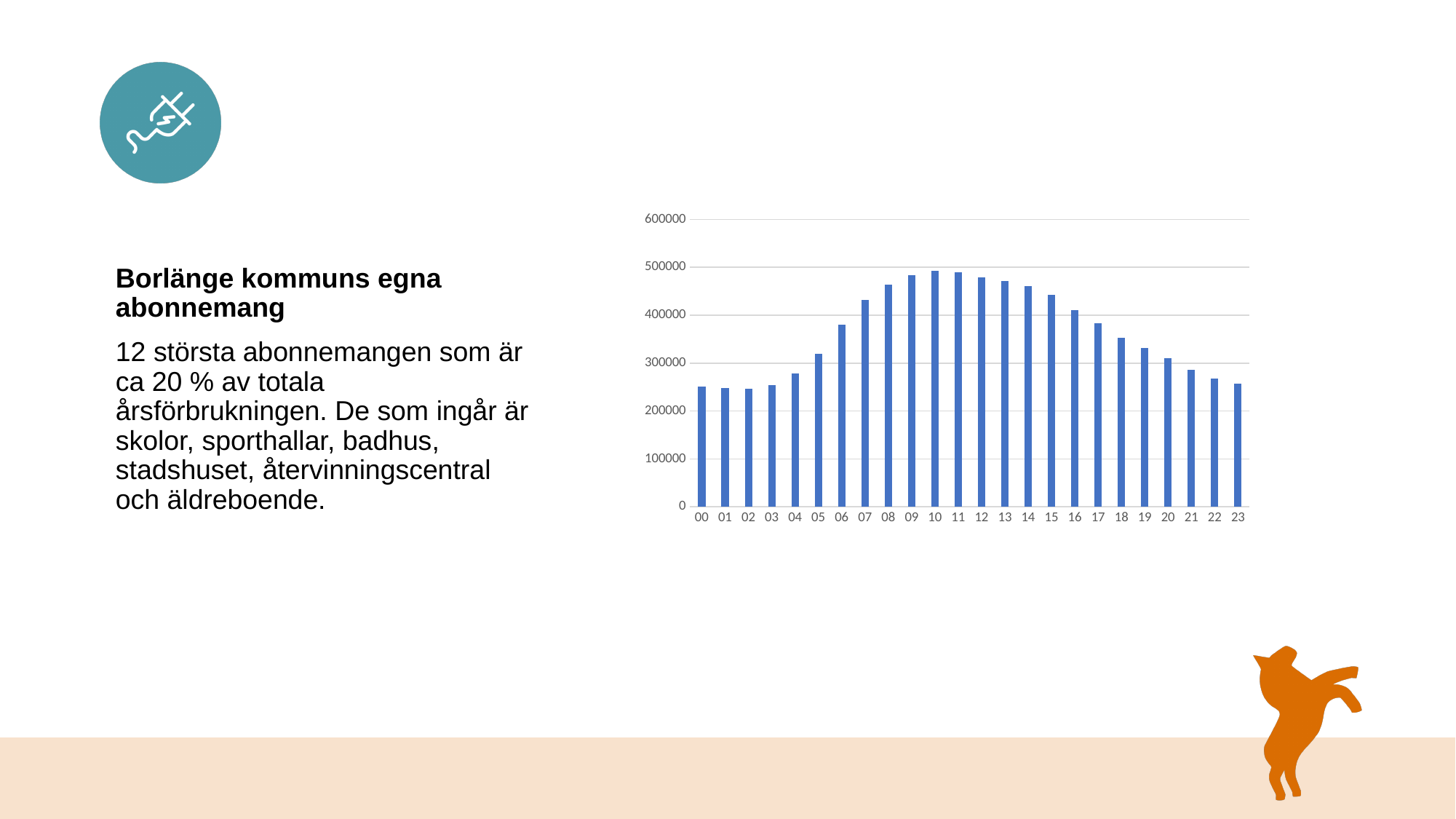
Which is larger, the value for 10 or the value for 00? 10 Do the values rise or fall from 00 to 10 along the x axis? rise Do the values rise or fall from 11 to 23 along the x axis? fall Which is larger, the value for 07 or the value for 19? 07 Is the value for 23 greater or less than 300000? less How many bars (categories) does the chart show? 24 Is the value for 17 greater or less than 400000? less What kind of chart is shown on the slide? bar chart Is the value for 08 greater or less than 400000? greater